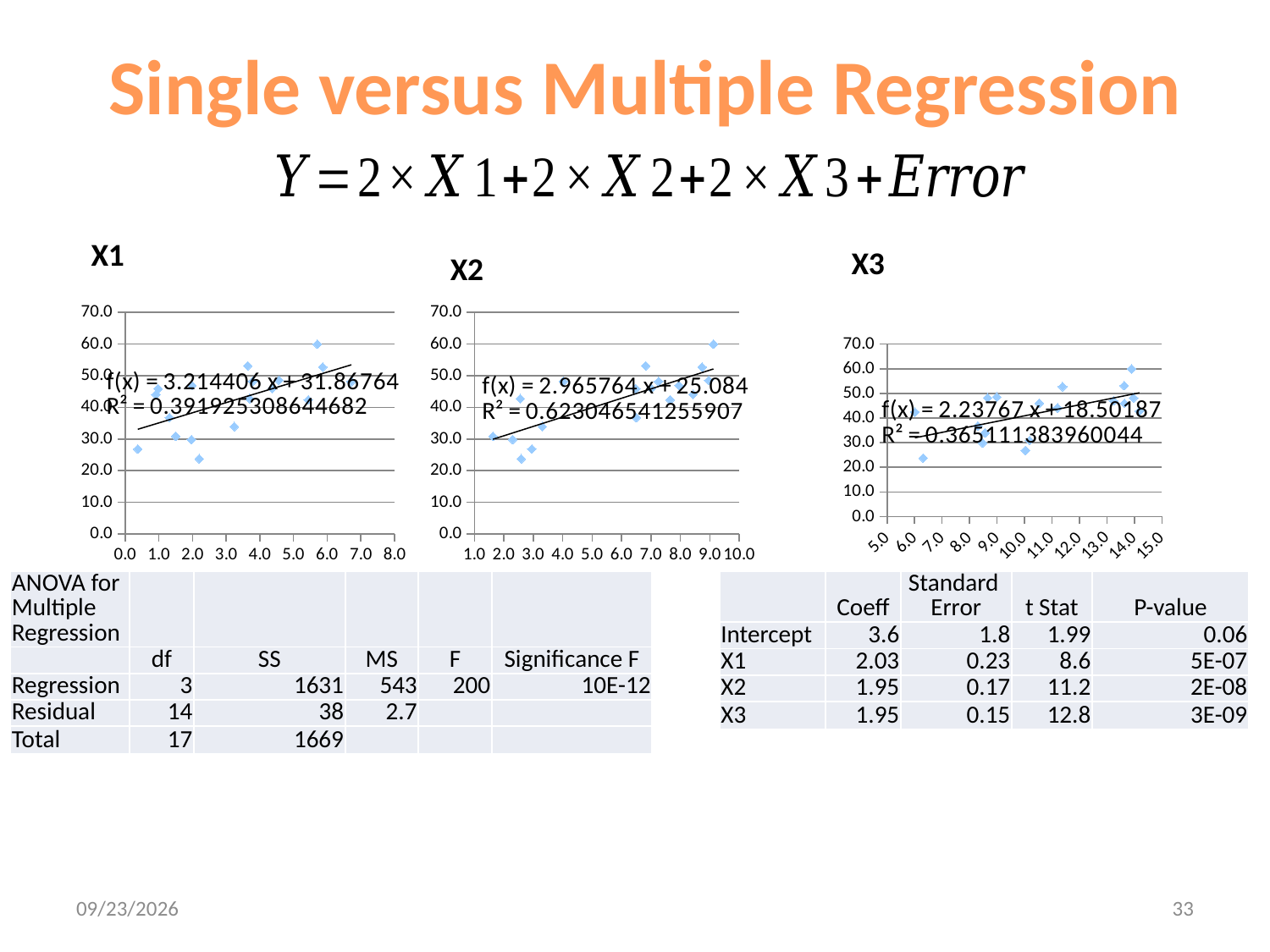
What kind of chart is the X1 chart? scatter chart On the X1 chart, do the plotted values generally rise or fall as x increases? rise How many charts are shown on the slide? 3 On the X3 chart, what is the R² value printed on the chart? 0.365111383960044 On the X2 chart, what is the R² value printed on the chart? 0.623046541255907 On the X1 chart, what is the R² value printed on the chart? 0.391925308644682 On the X3 chart, what is the trendline equation printed on the chart? f(x) = 2.23767 x + 18.50187 On the X2 chart, is the value of the highest plotted point greater or less than 50.0? greater Which of the three charts (X1, X2, X3) shows the highest R² value? X2 On the X3 chart, is the value of the lowest plotted point greater or less than 30.0? less Which of the three charts (X1, X2, X3) shows the lowest R² value? X3 On the X2 chart, what is the trendline equation printed on the chart? f(x) = 2.965764 x + 25.084